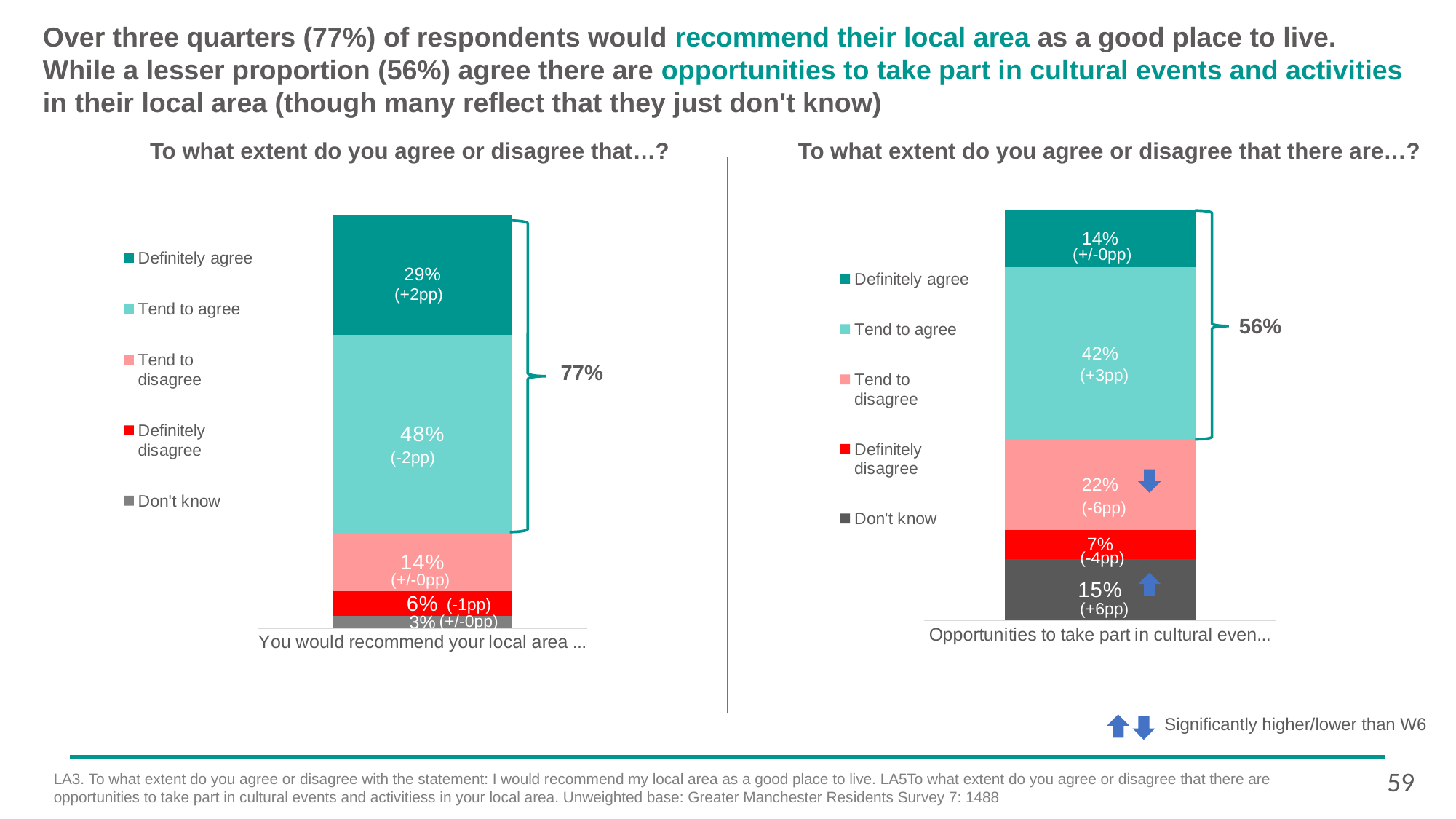
Which chart has the larger 'Definitely agree' share, the left chart (recommend your local area) or the right chart (opportunities to take part in cultural events)? The left chart (recommend your local area) In the left chart (recommend your local area), what percentage of respondents 'Tend to agree'? 48% How many response categories does the legend list in the left chart? 5 In the right chart (opportunities to take part in cultural events), what percentage of respondents answered 'Don't know'? 15% In the left chart (recommend your local area), what is the difference between the 'Tend to agree' and 'Definitely agree' percentages? 19 percentage points In the right chart (opportunities to take part in cultural events), what is the combined percentage of 'Definitely agree' and 'Tend to agree' shown by the bracket? 56% In the right chart (opportunities to take part in cultural events), which response category has the smallest share? Definitely disagree In the left chart (recommend your local area), which response category has the largest share? Tend to agree What type of chart is used on this slide? Stacked bar chart In the left chart (recommend your local area), which response category has the smallest share? Don't know In the left chart (recommend your local area), what percentage of respondents 'Definitely agree'? 29% In the right chart (opportunities to take part in cultural events), what percentage of respondents 'Tend to disagree'? 22%